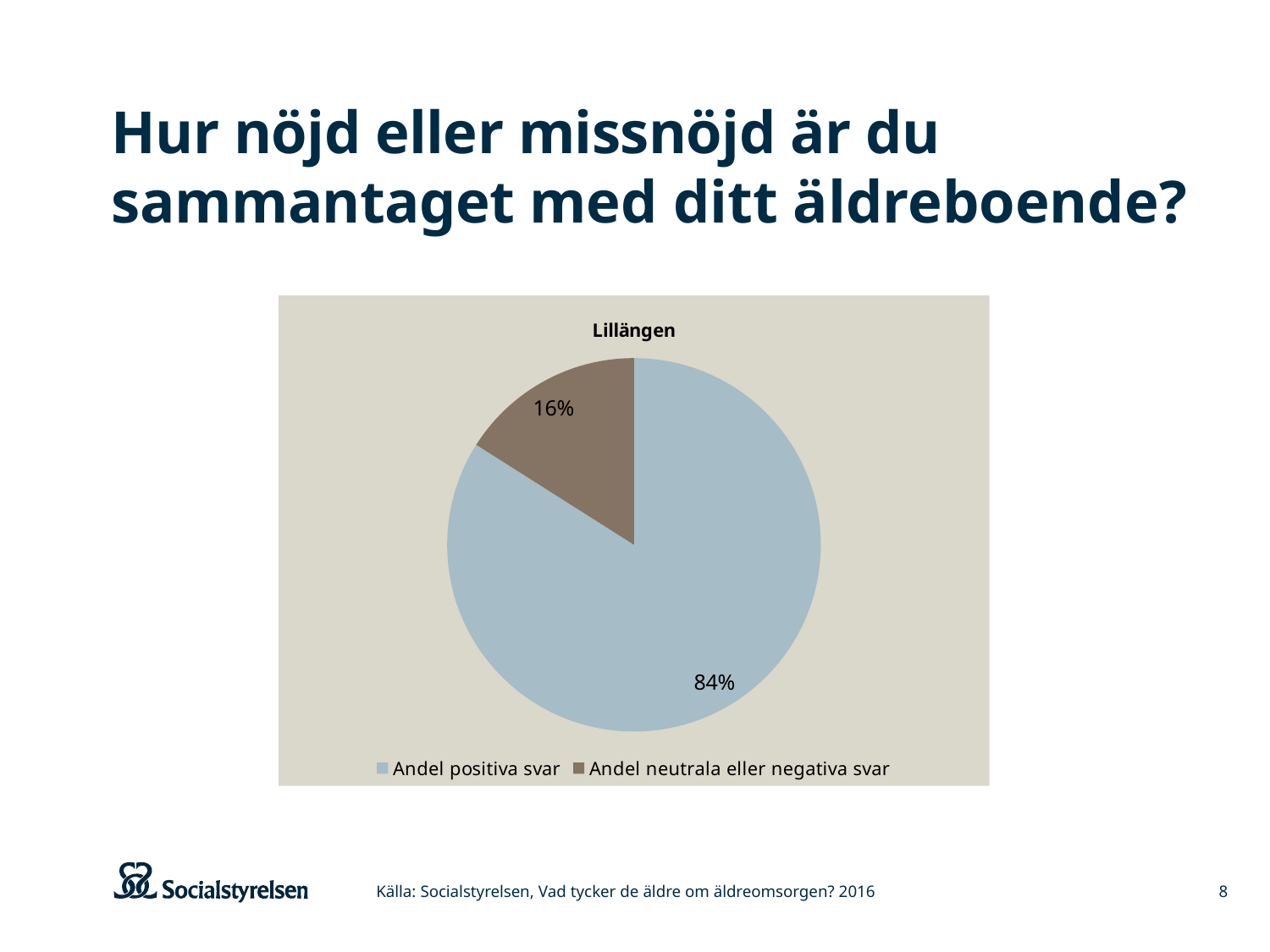
What share of the pie is 'Andel neutrala eller negativa svar'? 16% What colour is the slice for 'Andel neutrala eller negativa svar'? brown Which slice of the pie is the largest? Andel positiva svar Which is larger, 'Andel positiva svar' or 'Andel neutrala eller negativa svar'? Andel positiva svar What share of the pie is 'Andel positiva svar'? 84% What is the difference in percentage points between 'Andel positiva svar' and 'Andel neutrala eller negativa svar'? 68 percentage points How many slices does the pie chart have? 2 What kind of chart is shown on the slide? pie chart What is the title of the chart? Lillängen How many entries does the legend list? 2 Is the share for 'Andel positiva svar' greater or less than 50%? greater Which slice of the pie is the smallest? Andel neutrala eller negativa svar